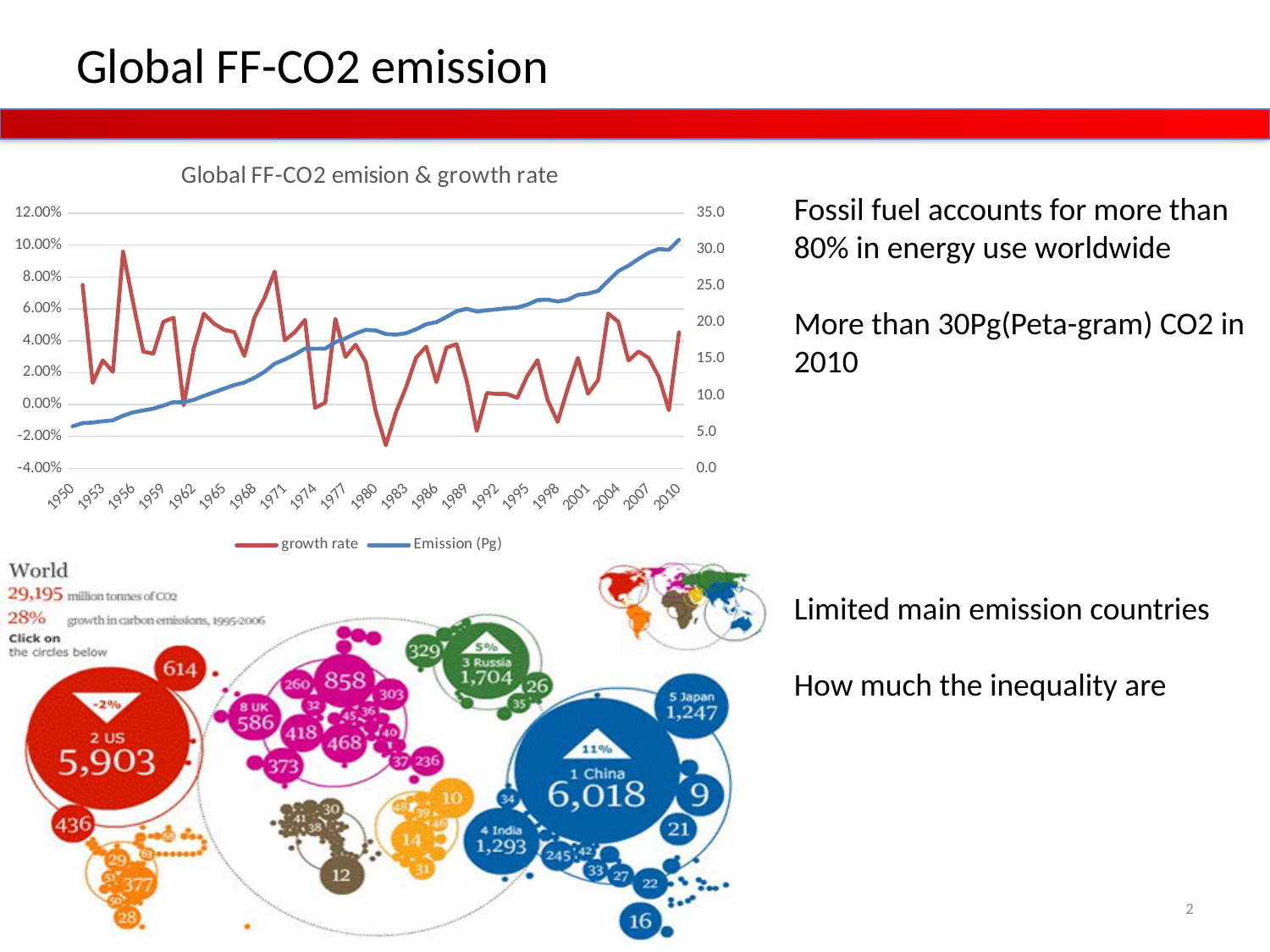
In the 'Global FF-CO2 emision & growth rate' chart, is the Emission (Pg) value for 1950 greater or less than 5.0? greater In the 'Global FF-CO2 emision & growth rate' chart, is the Emission (Pg) value for 2010 greater or less than 30.0? greater In the 'Global FF-CO2 emision & growth rate' chart, is the growth rate for 1956 greater or less than 8.00%? less In the bubble chart at the bottom of the slide, which is larger, the value for China or the value for the US? China How many series does the legend of the 'Global FF-CO2 emision & growth rate' chart list? 2 What kind of chart is 'Global FF-CO2 emision & growth rate'? line chart In the 'Global FF-CO2 emision & growth rate' chart, which series is drawn in blue? Emission (Pg) In the bubble chart at the bottom of the slide, what value is shown for China? 6,018 In the 'Global FF-CO2 emision & growth rate' chart, does the Emission (Pg) series generally rise or fall from 1950 to 2010? rise In the bubble chart at the bottom of the slide, what is the difference between the value for China (6,018) and the value for the US (5,903)? 115